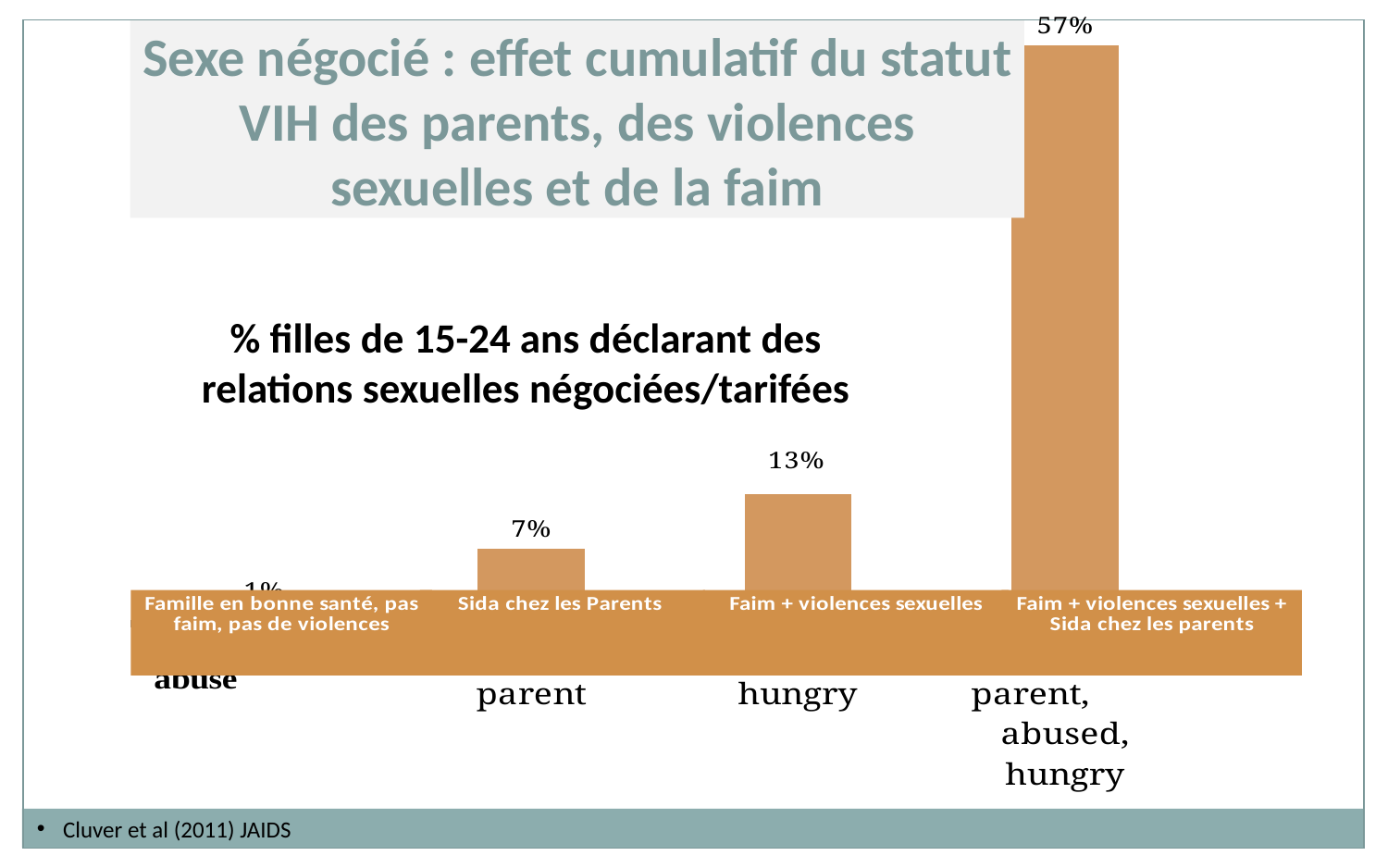
What is the difference between the 'Faim + violences sexuelles' value and the 'Sida chez les Parents' value? 6% What is the value shown for the 'Faim + violences sexuelles + Sida chez les parents' bar? 57% Which category has the highest percentage of girls reporting negotiated/paid sex? Faim + violences sexuelles + Sida chez les parents What is the difference between the 'Faim + violences sexuelles + Sida chez les parents' value and the 'Faim + violences sexuelles' value? 44% What is the value shown for the 'Faim + violences sexuelles' bar? 13% What type of chart is shown on the slide? Bar chart How many categories are shown in the chart? 4 Do the values rise or fall moving from left to right across the categories? Rise Which is larger: the value for 'Sida chez les Parents' or the value for 'Faim + violences sexuelles'? Faim + violences sexuelles What is the chart's subtitle describing what is measured? % filles de 15-24 ans déclarant des relations sexuelles négociées/tarifées Which category has the lowest percentage of girls reporting negotiated/paid sex? Famille en bonne santé, pas faim, pas de violences What percentage of girls aged 15-24 report negotiated/paid sex in the 'Sida chez les Parents' category? 7%